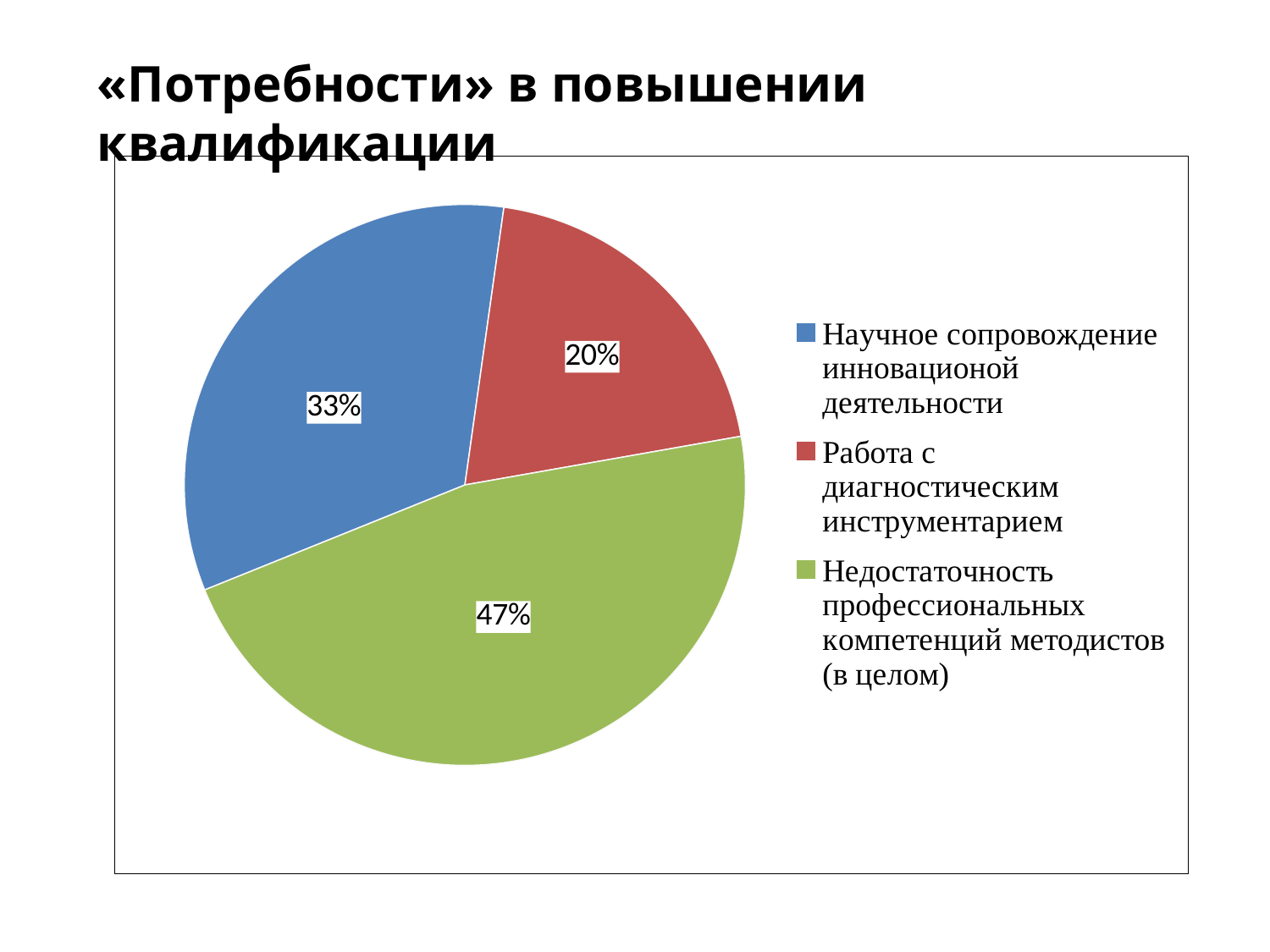
Which category has the largest slice of the pie? Недостаточность профессиональных компетенций методистов (в целом) What share of the pie does "Научное сопровождение инновационой деятельности" have? 33% What is the difference in percentage points between "Недостаточность профессиональных компетенций методистов (в целом)" and "Научное сопровождение инновационой деятельности"? 14 What share of the pie does "Недостаточность профессиональных компетенций методистов (в целом)" have? 47% What type of chart is shown on the slide? pie chart What share of the pie does "Работа с диагностическим инструментарием" have? 20% What colour is the slice for "Работа с диагностическим инструментарием"? red Which is larger: the slice for "Научное сопровождение инновационой деятельности" or the slice for "Работа с диагностическим инструментарием"? Научное сопровождение инновационой деятельности What is the difference in percentage points between the largest and smallest slices? 27 What is the title of the slide containing the chart? «Потребности» в повышении квалификации Which category has the smallest slice of the pie? Работа с диагностическим инструментарием How many categories does the pie chart show? 3